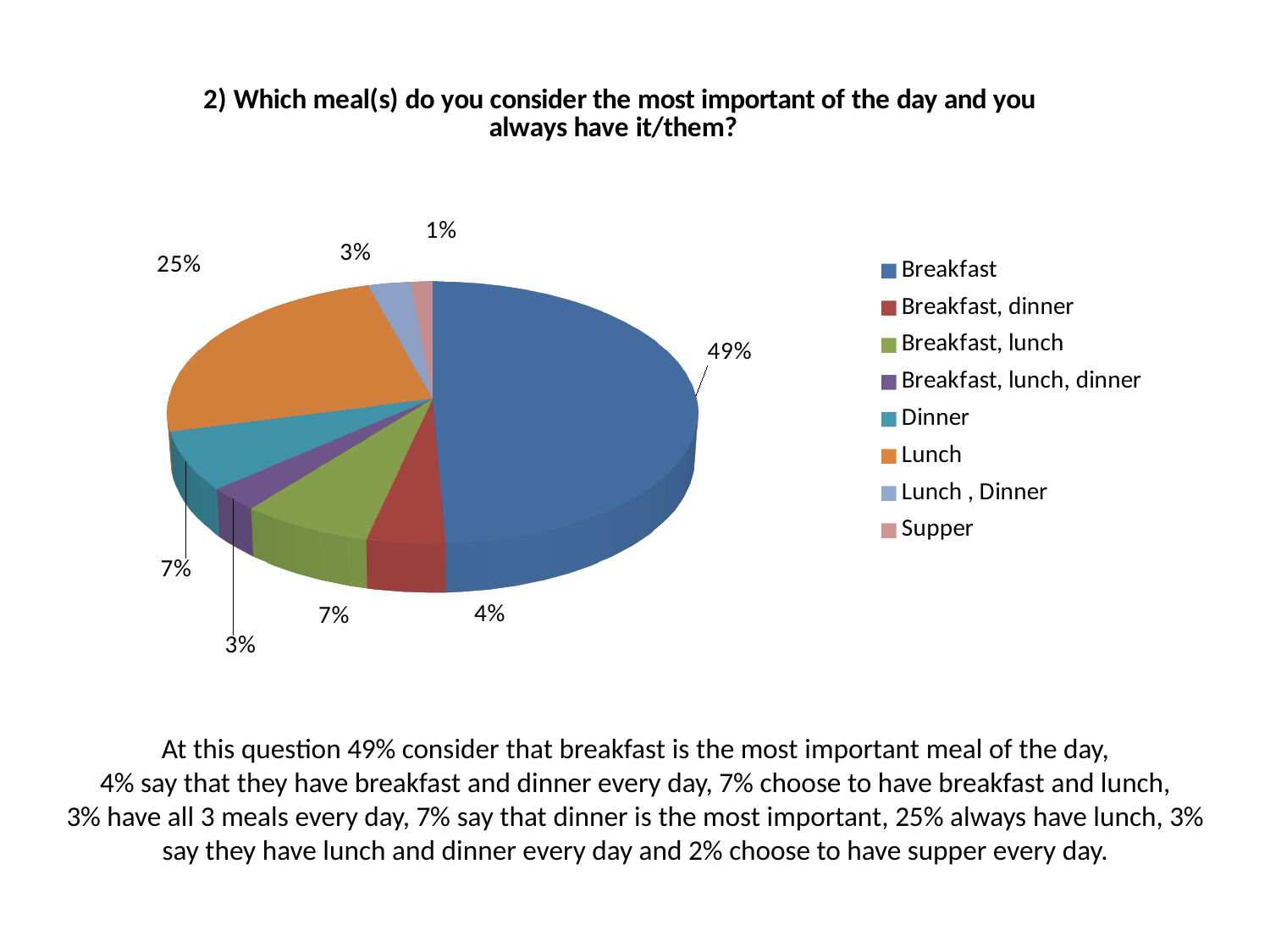
What percentage of the pie is the Breakfast slice? 49% What colour is the Lunch slice in the pie chart? orange What percentage of the pie is the Breakfast, dinner slice? 4% Which category has the largest slice of the pie? Breakfast What is the difference in percentage points between the Breakfast slice and the Lunch slice? 24 Which category has the smallest slice of the pie? Supper What kind of chart is shown on the slide? pie chart What percentage of the pie is the Dinner slice? 7% How many categories does the legend list? 8 What percentage of the pie is the Supper slice? 1% Which slice is larger, Breakfast, lunch or Breakfast, dinner? Breakfast, lunch What percentage of the pie is the Lunch slice? 25%